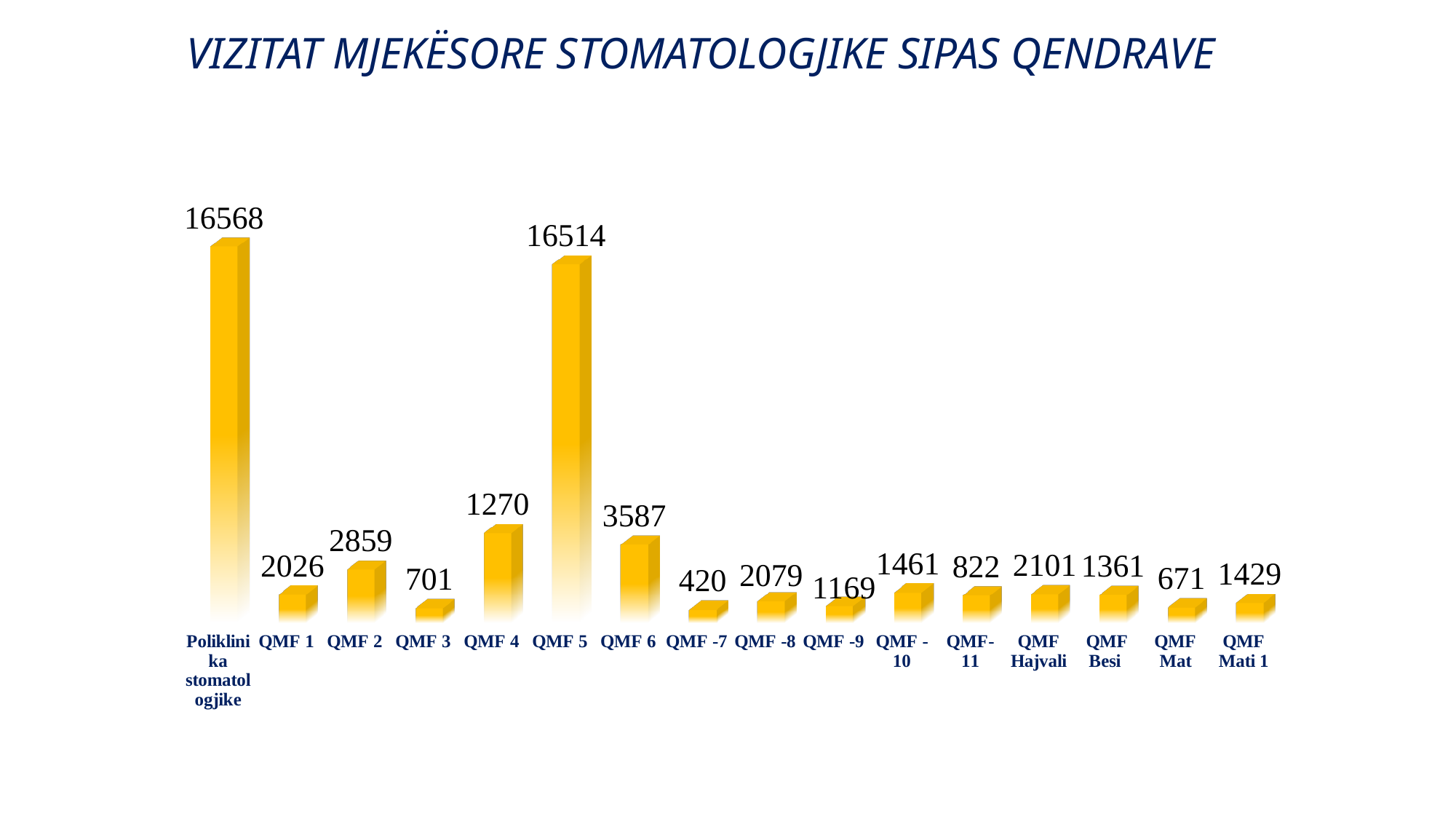
Which is larger, the value for QMF 1 or the value for QMF -8? QMF -8 What is the title of the chart? VIZITAT MJEKËSORE STOMATOLOGJIKE SIPAS QENDRAVE Which category has the lowest value? QMF -7 What is the value for QMF Hajvali? 2101 Which category has the highest value? Poliklinika stomatologjike How many categories are shown in the chart? 16 What kind of chart is shown on the slide? Bar chart What is the difference between the values for Poliklinika stomatologjike and QMF 5? 54 What is the value for QMF 5? 16514 What is the difference between the values for QMF 6 and QMF 2? 728 What is the value for QMF Mati 1? 1429 What is the value for QMF 3? 701